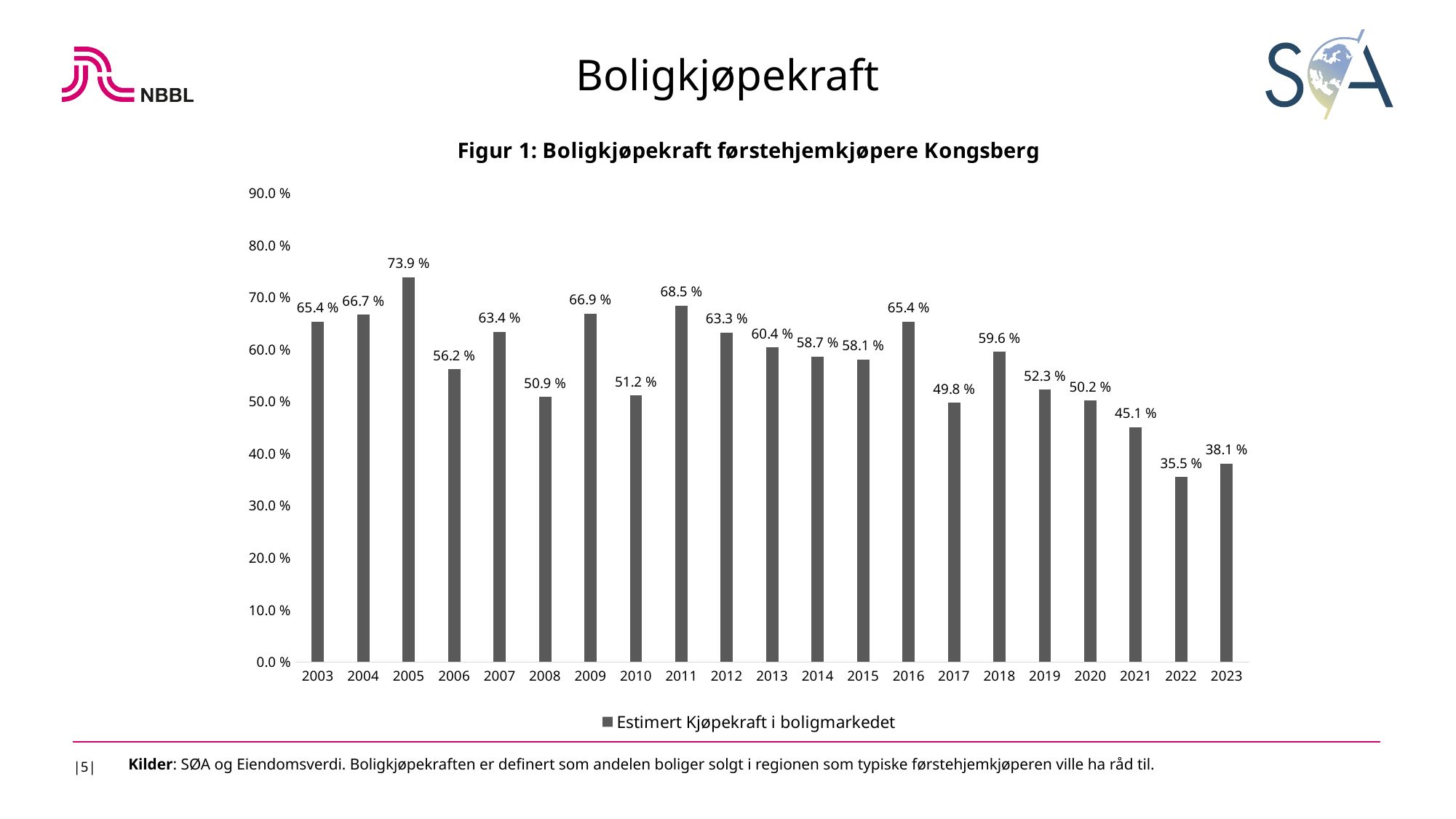
What is the value for 2017? 49.8 % How many years are shown on the x axis? 21 What kind of chart is shown? bar chart What is the difference between the values for 2023 and 2022? 2.6 percentage points What is the value for 2005? 73.9 % What is the difference between the values for 2005 and 2022? 38.4 percentage points Is the value for 2021 greater or less than 50.0 %? less Which year has the highest value? 2005 What is the name of the series in the legend? Estimert Kjøpekraft i boligmarkedet Which is larger, the value for 2011 or the value for 2016? 2011 Which year has the lowest value? 2022 What is the value for 2023? 38.1 %